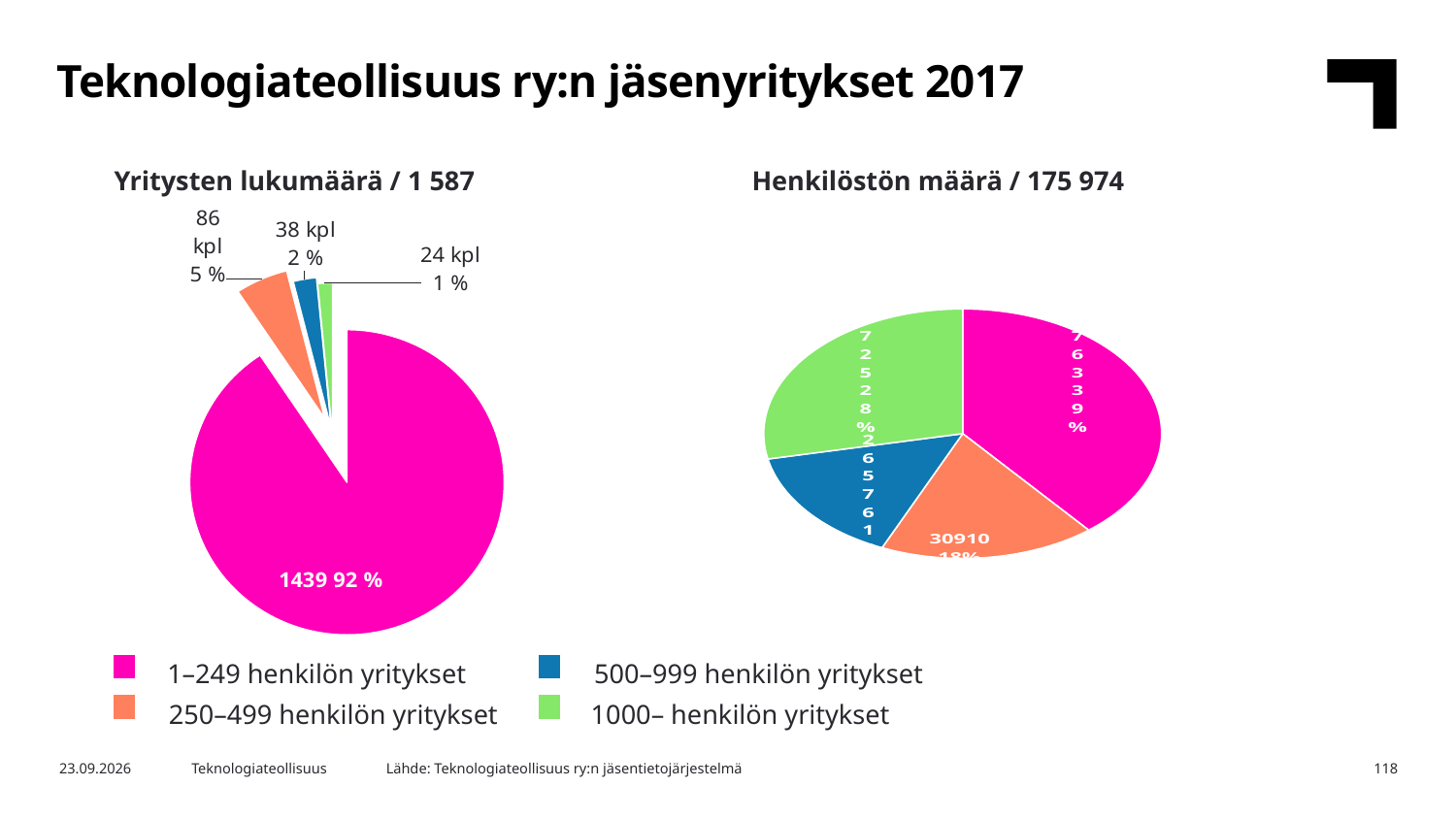
In the left chart 'Yritysten lukumäärä / 1 587', which category has the smallest slice? 1000– henkilön yritykset In the left chart 'Yritysten lukumäärä / 1 587', what is the value shown for 250–499 henkilön yritykset? 86 kpl In the left chart 'Yritysten lukumäärä / 1 587', what is the value shown for 1–249 henkilön yritykset? 1439 In the right chart 'Henkilöstön määrä / 175 974', what is the value shown for 250–499 henkilön yritykset? 30910 In the left chart 'Yritysten lukumäärä / 1 587', what is the difference between the number of 250–499 henkilön yritykset and 500–999 henkilön yritykset? 48 In the left chart 'Yritysten lukumäärä / 1 587', what is the value shown for 1000– henkilön yritykset? 24 kpl In the right chart 'Henkilöstön määrä / 175 974', which category has the largest slice? 1–249 henkilön yritykset In the left chart 'Yritysten lukumäärä / 1 587', what share of the pie do 1–249 henkilön yritykset have? 92 % How many slices does the left chart 'Yritysten lukumäärä / 1 587' have? 4 What kind of chart is the left chart titled 'Yritysten lukumäärä / 1 587'? pie chart In the left chart 'Yritysten lukumäärä / 1 587', which category has the largest slice? 1–249 henkilön yritykset In the left chart 'Yritysten lukumäärä / 1 587', what share of the pie do 500–999 henkilön yritykset have? 2 %